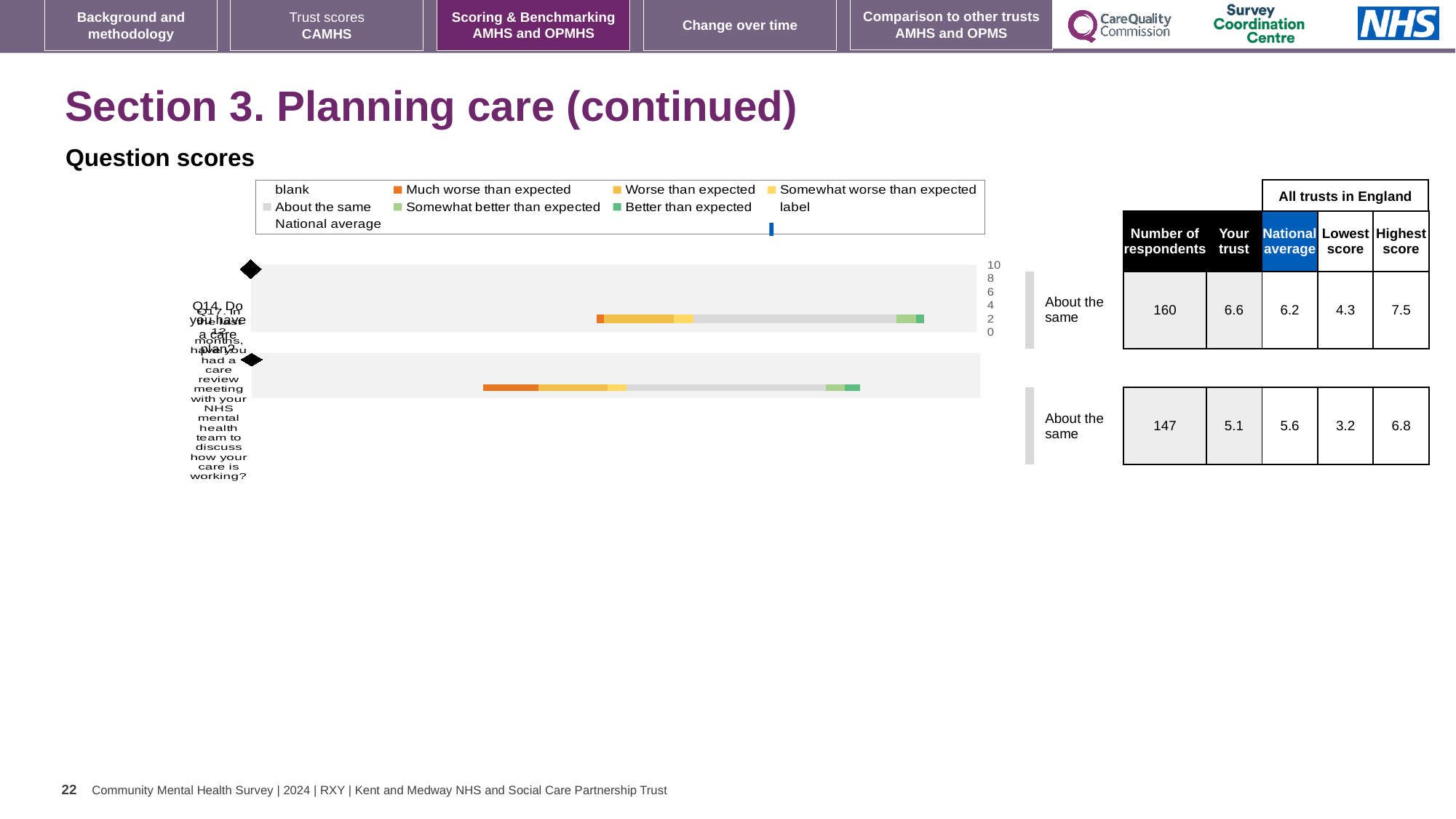
For the second row, by how much does the national average exceed the 'Your trust' score? 0.5 What is the national average for the top row of the chart? 6.2 For the top row, what is the difference between the highest score and the lowest score across all trusts in England? 3.2 What kind of chart is shown under 'Question scores'? bar chart How many question rows are plotted in the chart? 2 For the top row, which is larger: the 'Your trust' score or the national average? Your trust What benchmark category is shown to the right of both bars in the chart? About the same How many respondents are listed for the second row of the chart? 147 What colour does the legend use for 'Much worse than expected'? orange For the second row, which is larger: the 'Your trust' score or the national average? National average What is the highest score among all trusts in England for the second row? 6.8 What is the 'Your trust' score for the top row of the chart? 6.6